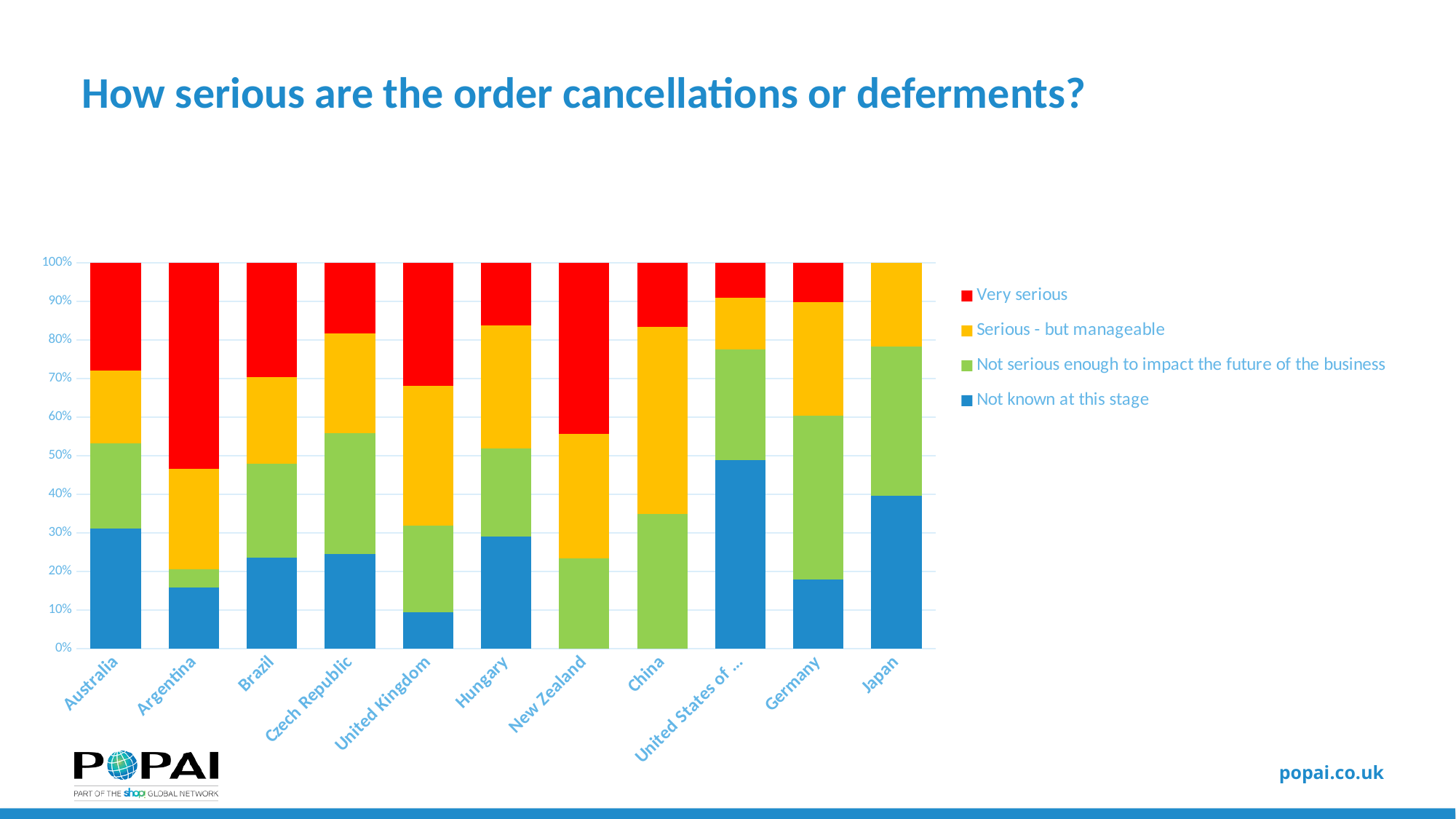
How many countries are shown on the x axis of the chart? 11 Is the 'Not known at this stage' share for the United States of ... greater or less than 40%? greater Is the 'Not known at this stage' share larger for Australia or Argentina? Australia How many series does the legend list? 4 Which legend entry is shown in red? Very serious Which country has the largest 'Not known at this stage' share? United States of ... Is the 'Not known at this stage' share for Argentina greater or less than 20%? less Which country has the largest 'Very serious' share? Argentina Is the 'Very serious' share larger for the United Kingdom or the Czech Republic? United Kingdom What is the title of the chart on the slide? How serious are the order cancellations or deferments? What kind of chart is shown on the slide? Stacked bar chart Which country has no 'Very serious' segment in its bar? Japan